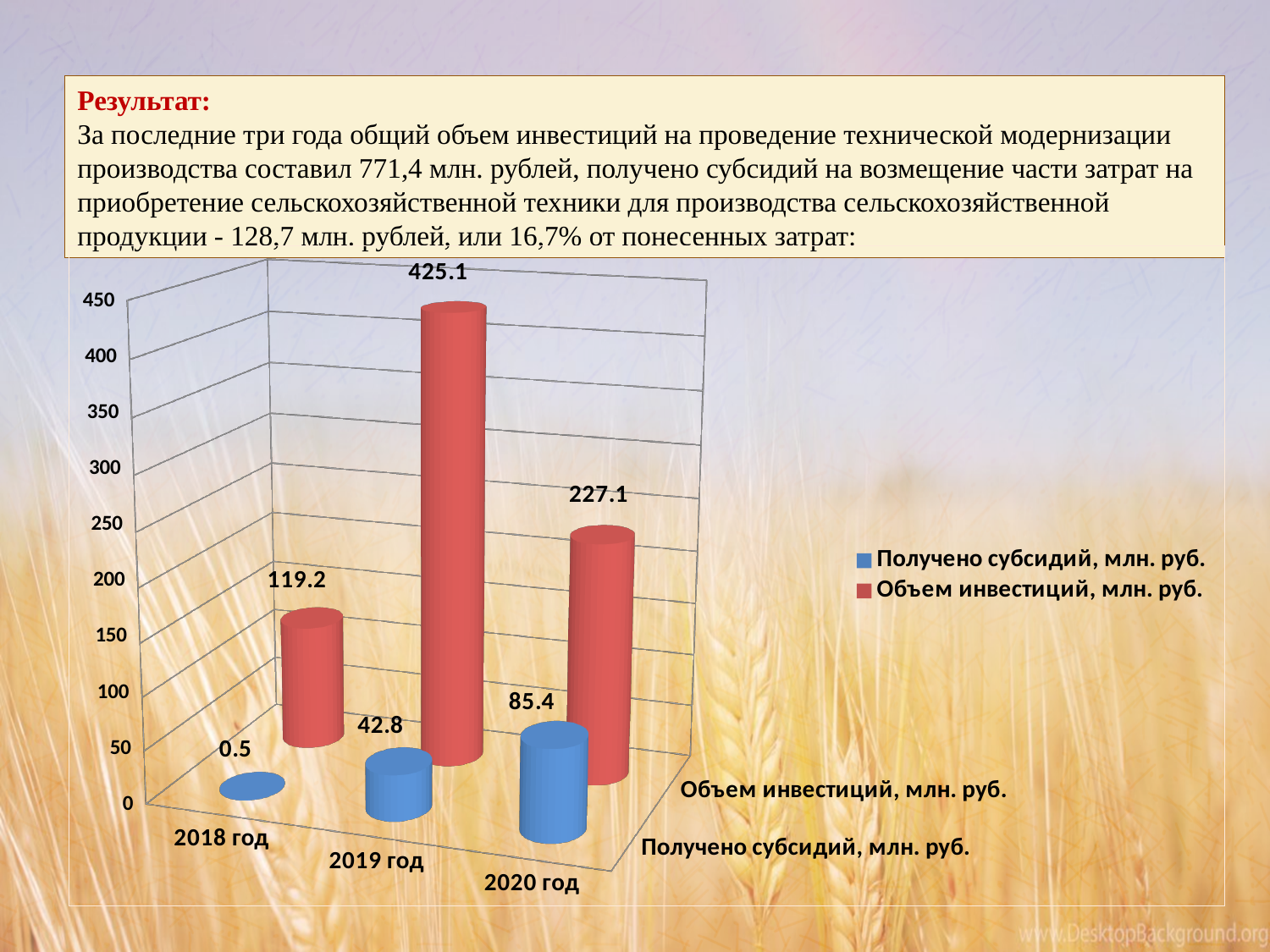
Does the value of Получено субсидий, млн. руб. rise or fall from 2018 год to 2020 год? Rise How many series does the chart legend list? 2 Which is larger: Получено субсидий, млн. руб. in 2019 год or in 2020 год? 2020 год Which year has the lowest value of Получено субсидий, млн. руб.? 2018 год Which year has the highest value of Объем инвестиций, млн. руб.? 2019 год What is the value of Объем инвестиций, млн. руб. for 2020 год? 227.1 What is the value of Получено субсидий, млн. руб. for 2020 год? 85.4 What kind of chart is shown on the slide? Bar chart What is the value of Объем инвестиций, млн. руб. for 2019 год? 425.1 What is the value of Получено субсидий, млн. руб. for 2018 год? 0.5 What is the difference between Объем инвестиций, млн. руб. in 2019 год and 2020 год? 198 How many years are shown on the x axis of the chart? 3